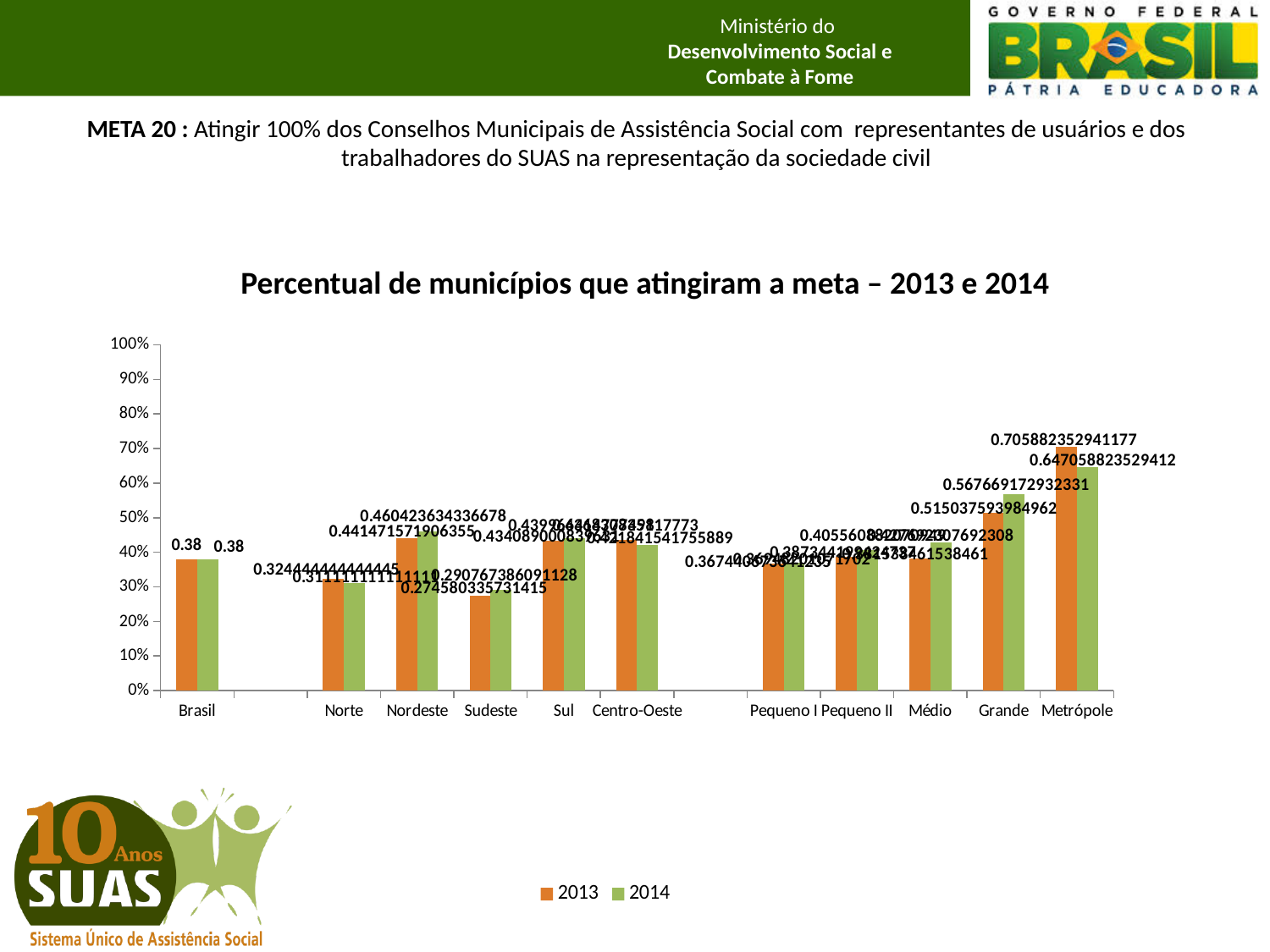
What is the value for Brasil in 2013? 0.38 What is the value for Metrópole in 2014? 0.647058823529412 What kind of chart is shown on the slide? bar chart What is the value for Metrópole in 2013? 0.705882352941177 What colour represents the 2013 series in the legend? orange What is the value for Grande in 2014? 0.567669172932331 How many categories are shown on the x axis? 11 How many series does the legend list? 2 Which category has the highest value for 2013? Metrópole Is the value for Grande in 2014 greater or less than 50%? greater Which category has the lowest value for 2013? Sudeste For Metrópole, which year has the larger value, 2013 or 2014? 2013